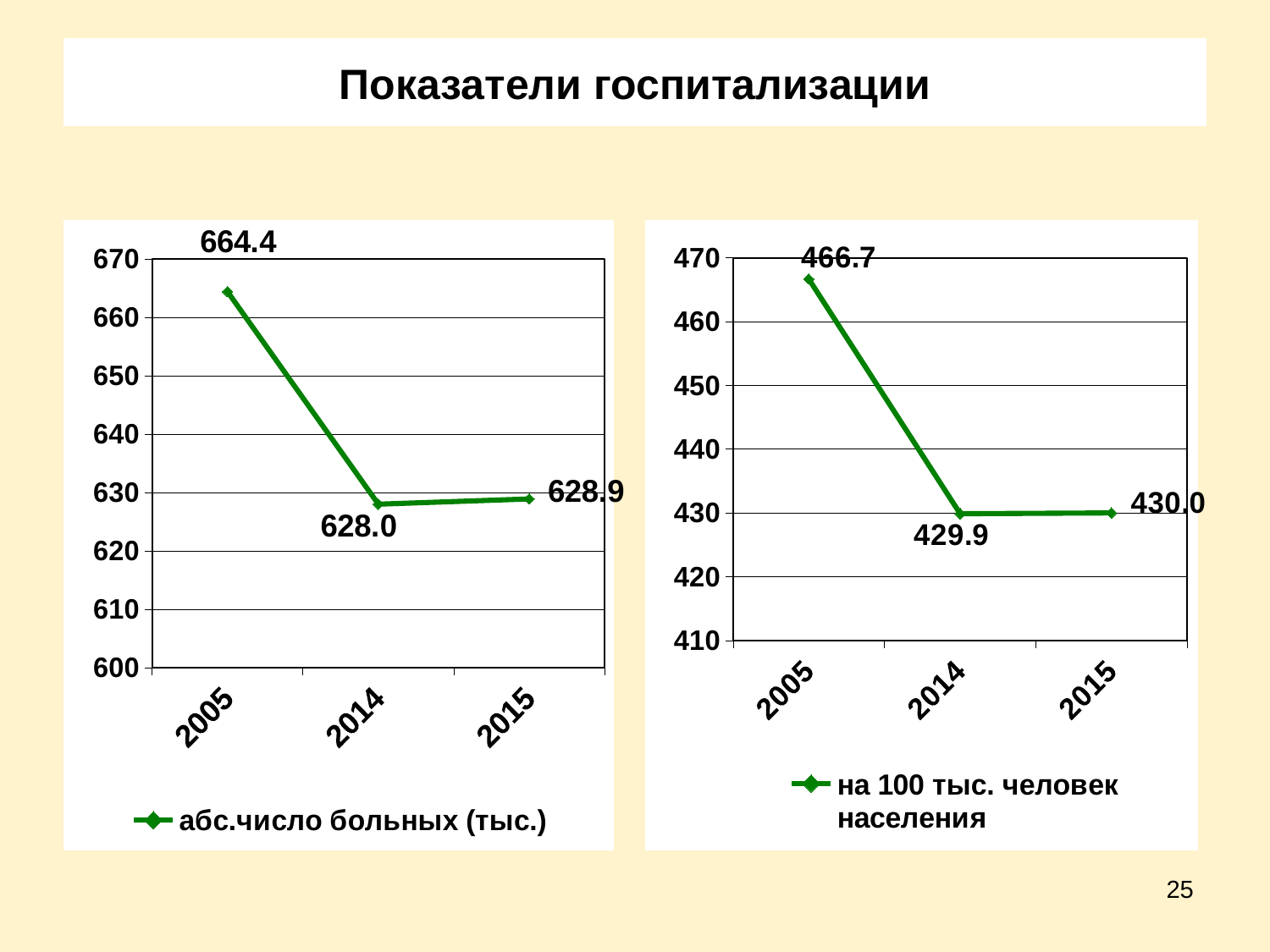
In the left chart (абс.число больных (тыс.)), which year has the highest value? 2005 In the right chart (на 100 тыс. человек населения), what is the value for 2014? 429.9 In the left chart (абс.число больных (тыс.)), what is the value for 2005? 664.4 How many data points are plotted in the right chart (на 100 тыс. человек населения)? 3 In the right chart (на 100 тыс. человек населения), do the values rise or fall from 2005 to 2014? fall In the left chart (абс.число больных (тыс.)), what is the value for 2014? 628.0 What type of chart is the left chart (абс.число больных (тыс.))? line chart In the right chart (на 100 тыс. человек населения), what is the difference between the 2005 and 2015 values? 36.7 In the left chart (абс.число больных (тыс.)), what is the difference between the 2005 and 2014 values? 36.4 In the right chart (на 100 тыс. человек населения), which year has the highest value? 2005 In the left chart (абс.число больных (тыс.)), is the value for 2005 greater or less than 660? greater In the right chart (на 100 тыс. человек населения), what is the value for 2015? 430.0